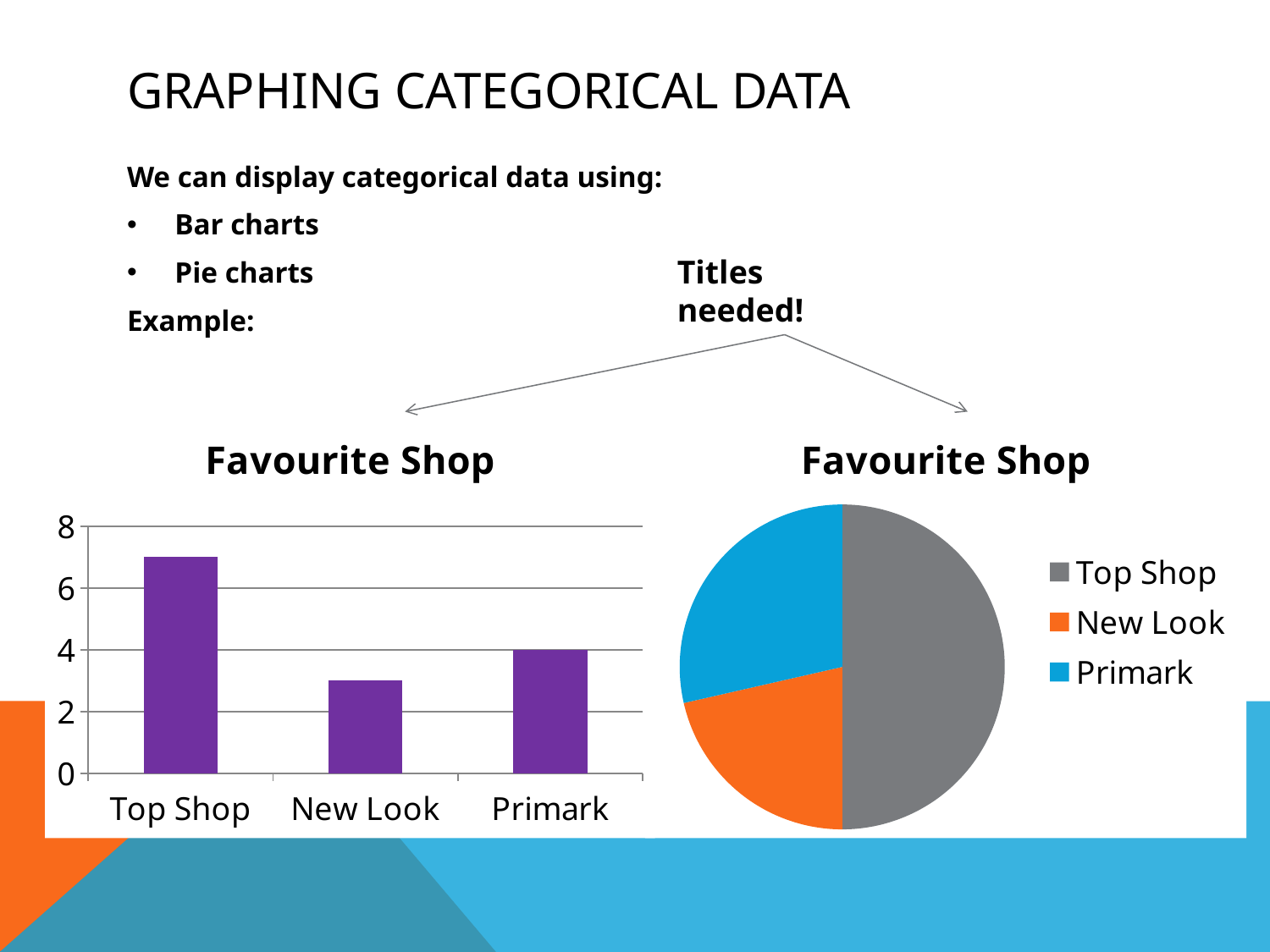
In the bar chart on the left, which shop has the lowest bar? New Look In the bar chart on the left, which is larger, the value for Top Shop or the value for Primark? Top Shop What type of chart is the chart on the left of the slide? bar chart In the bar chart on the left, which shop has the highest bar? Top Shop What is the title of the bar chart on the left? Favourite Shop What type of chart is the chart on the right of the slide? pie chart In the pie chart on the right, which shop has the largest slice? Top Shop How many categories are shown on the x axis of the bar chart on the left? 3 In the bar chart on the left, is the value for New Look greater or less than 4? less In the bar chart on the left, is the value for Top Shop greater or less than 6? greater In the bar chart on the left, what is the value for Primark? 4 How many entries does the legend of the pie chart on the right list? 3